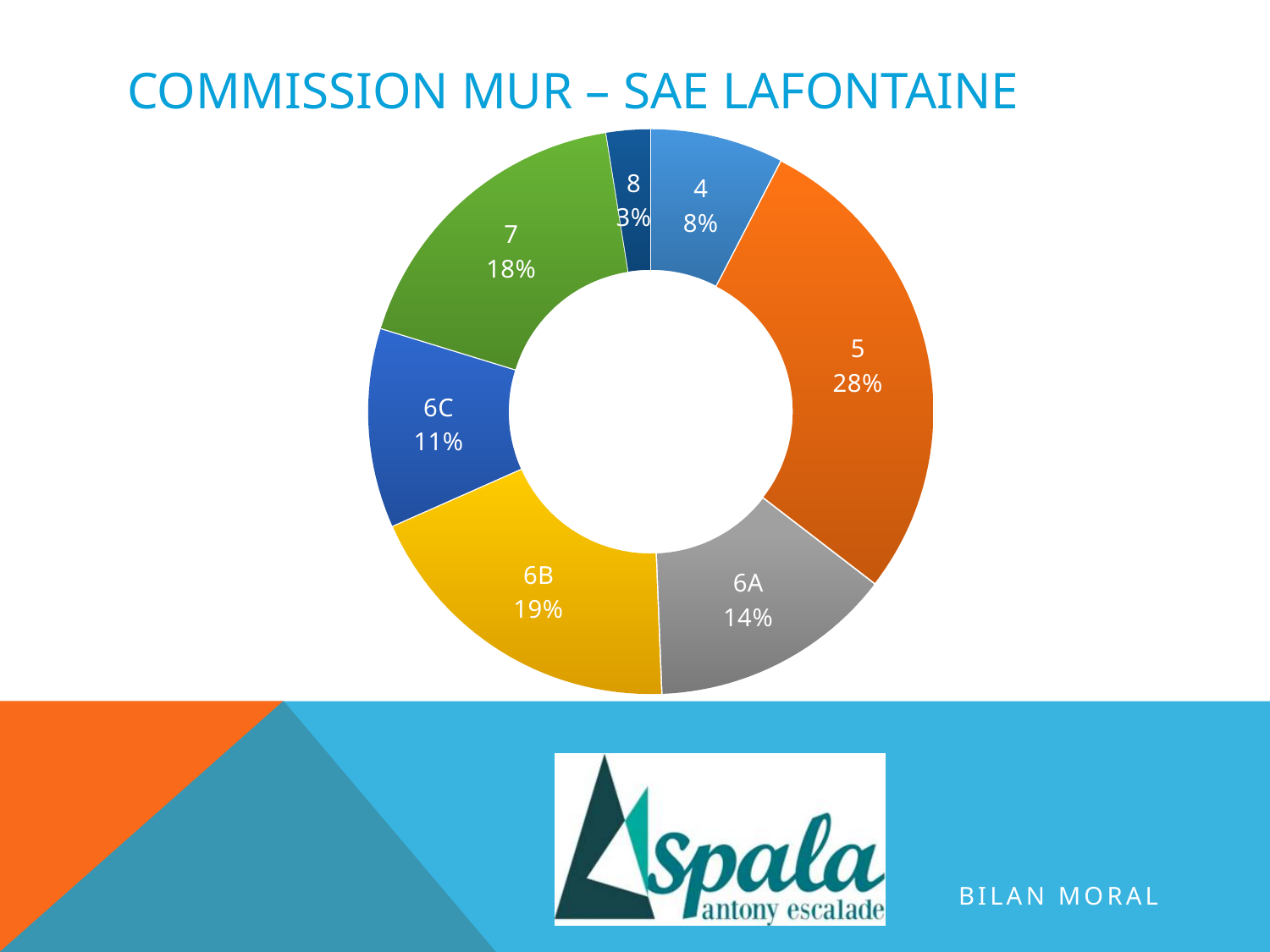
What is the difference in percentage points between category 5 and category 6A? 14 Which category has the smallest share of the chart? 8 Which category has the largest share of the chart? 5 What percentage is shown for category 7? 18% How many categories are shown in the chart? 7 What percentage is shown for category 6C? 11% Which has a larger share, category 6B or category 7? 6B What percentage is shown for category 6B? 19% What share of the chart does category 5 represent? 28% What is the title of the slide containing the chart? COMMISSION MUR – SAE LAFONTAINE What is the difference in percentage points between category 4 and category 8? 5 What kind of chart is shown on the slide? Doughnut chart